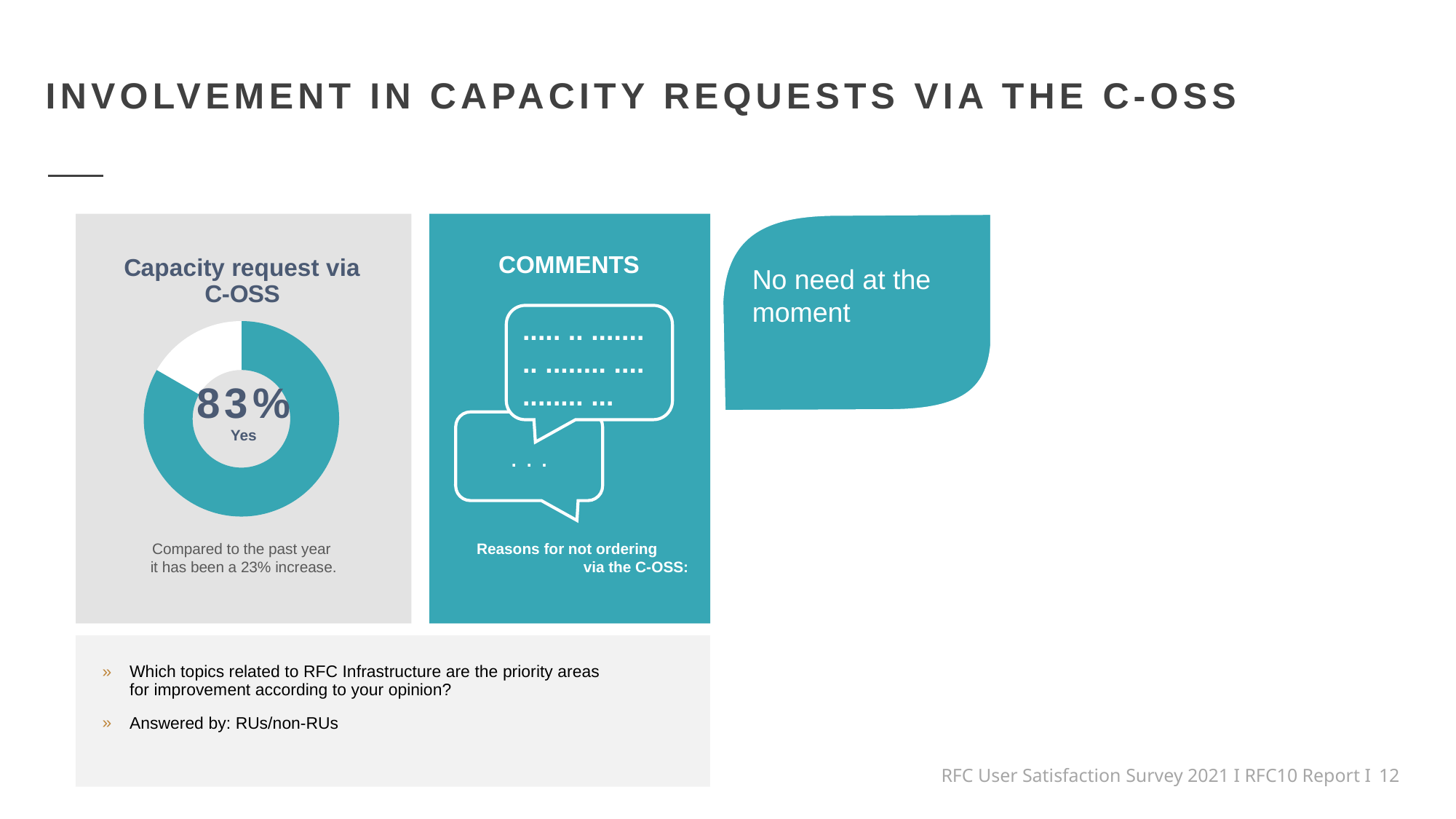
What share of the "Capacity request via C-OSS" pie does the "Yes" slice represent? 83% In the "Capacity request via C-OSS" chart, which slice is larger: the "Yes" slice or the remaining slice? Yes What colour is the "Yes" slice in the "Capacity request via C-OSS" chart? teal What percentage of respondents answered "Yes" in the "Capacity request via C-OSS" chart? 83% What is the title of the pie chart on the slide? Capacity request via C-OSS What kind of chart is shown under the heading "Capacity request via C-OSS"? doughnut chart Is the "Yes" share in the "Capacity request via C-OSS" chart greater or less than 50%? greater How many slices does the "Capacity request via C-OSS" pie chart have? 2